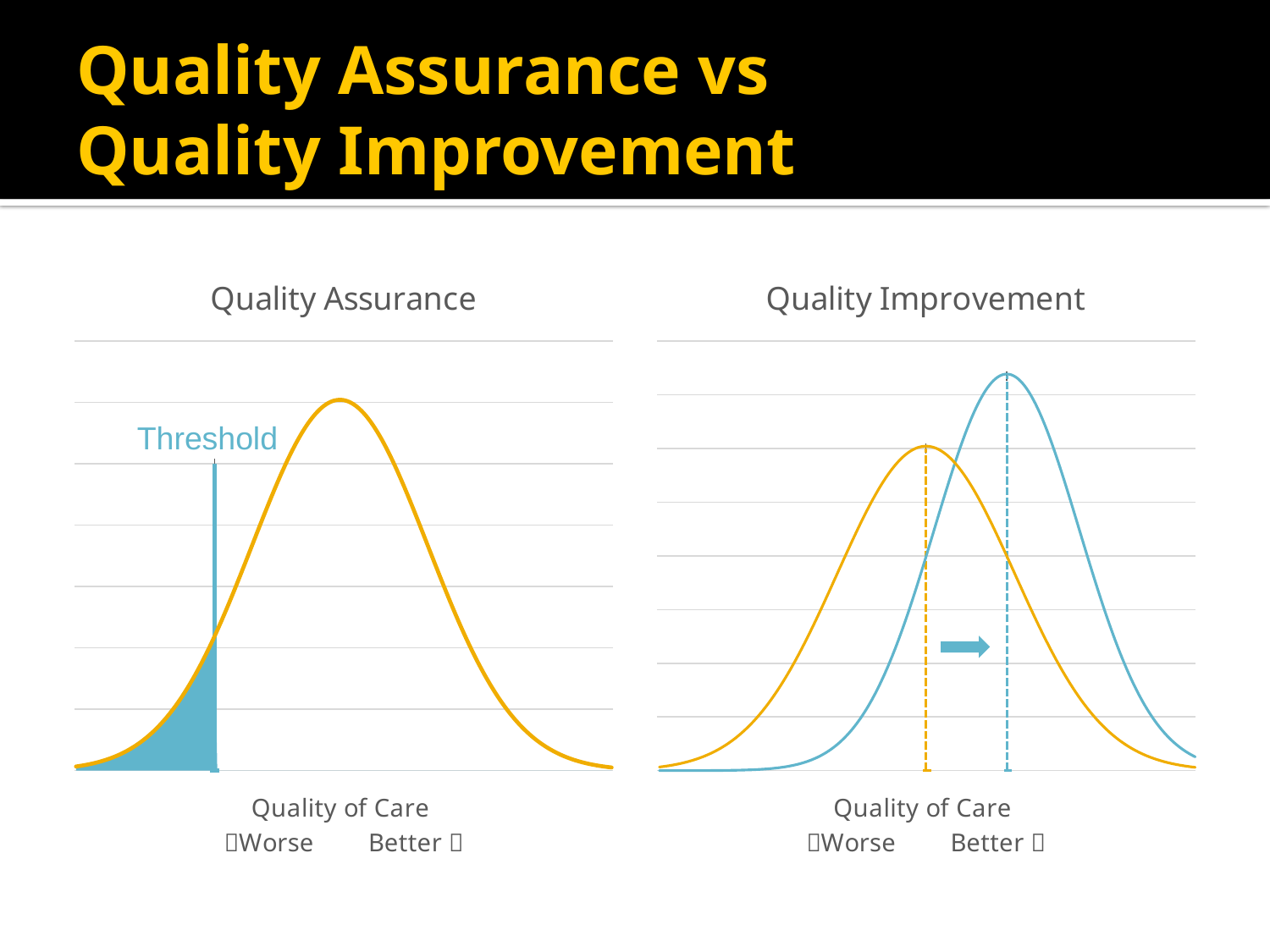
In the Quality Improvement chart, which curve reaches the higher peak, the blue one or the orange one? The blue one What kind of chart is the Quality Improvement chart on the right? Line chart How many curves are plotted in the Quality Improvement chart on the right? 2 What is the x-axis label on the Quality Assurance chart? Quality of Care What kind of chart is the Quality Assurance chart on the left? Line chart How many curves are plotted in the Quality Assurance chart on the left? 1 In the Quality Assurance chart, is the shaded area to the left or to the right of the threshold line? To the left What is the label on the vertical line in the Quality Assurance chart? Threshold In the Quality Improvement chart, is the peak of the blue curve to the left or to the right of the peak of the orange curve? To the right